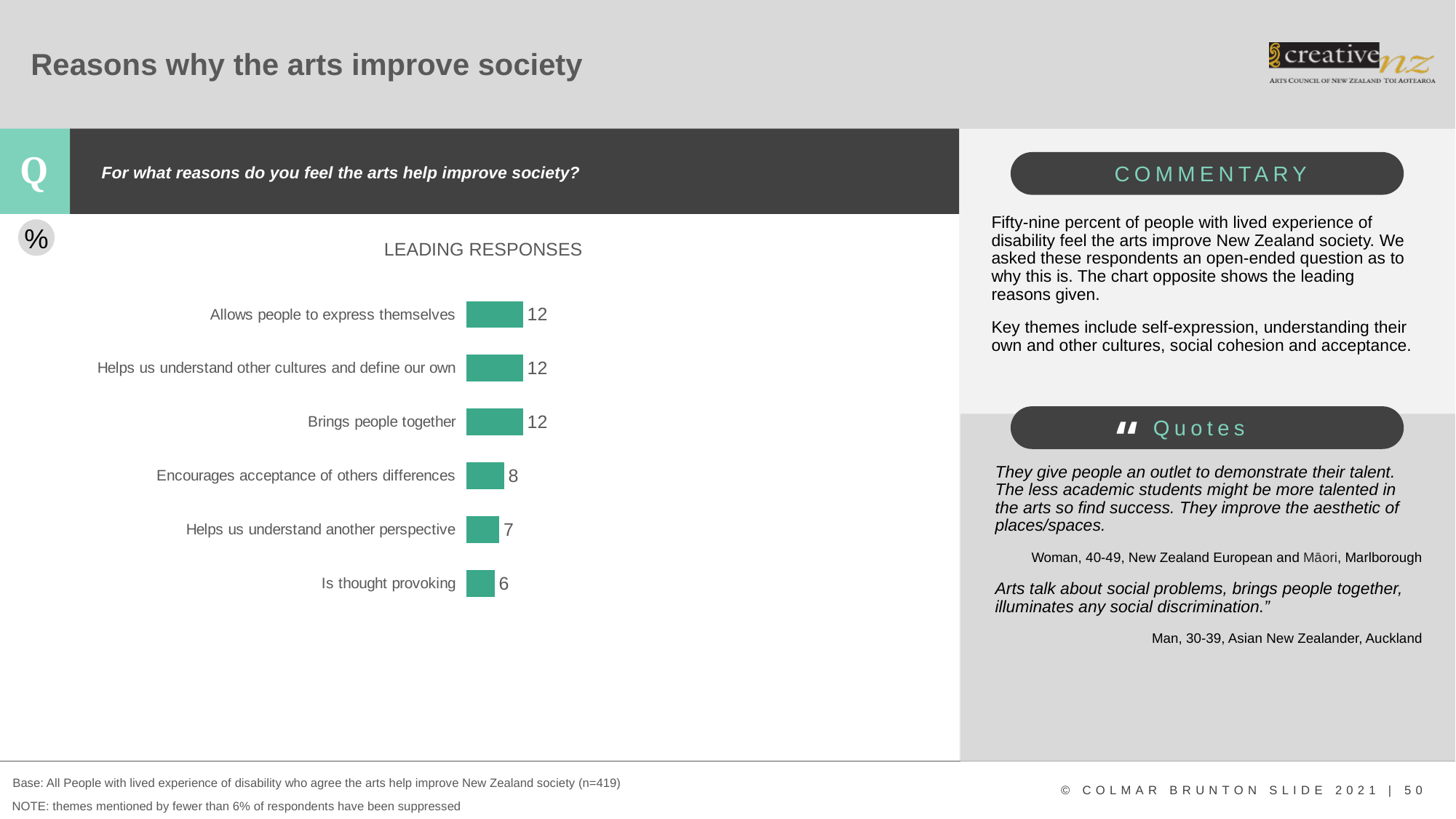
What is the value for "Encourages acceptance of others differences"? 8 What is the difference between the values for "Brings people together" and "Is thought provoking"? 6 What kind of chart is shown on the slide? Bar chart What is the value for "Allows people to express themselves"? 12 What is the value for "Is thought provoking"? 6 Which category has the lowest value? Is thought provoking What is the title of the chart? LEADING RESPONSES How many categories share the highest value of 12? 3 What is the difference between the values for "Encourages acceptance of others differences" and "Helps us understand another perspective"? 1 How many categories are shown in the chart? 6 Which is larger: the value for "Helps us understand other cultures and define our own" or the value for "Encourages acceptance of others differences"? Helps us understand other cultures and define our own What is the value for "Helps us understand another perspective"? 7